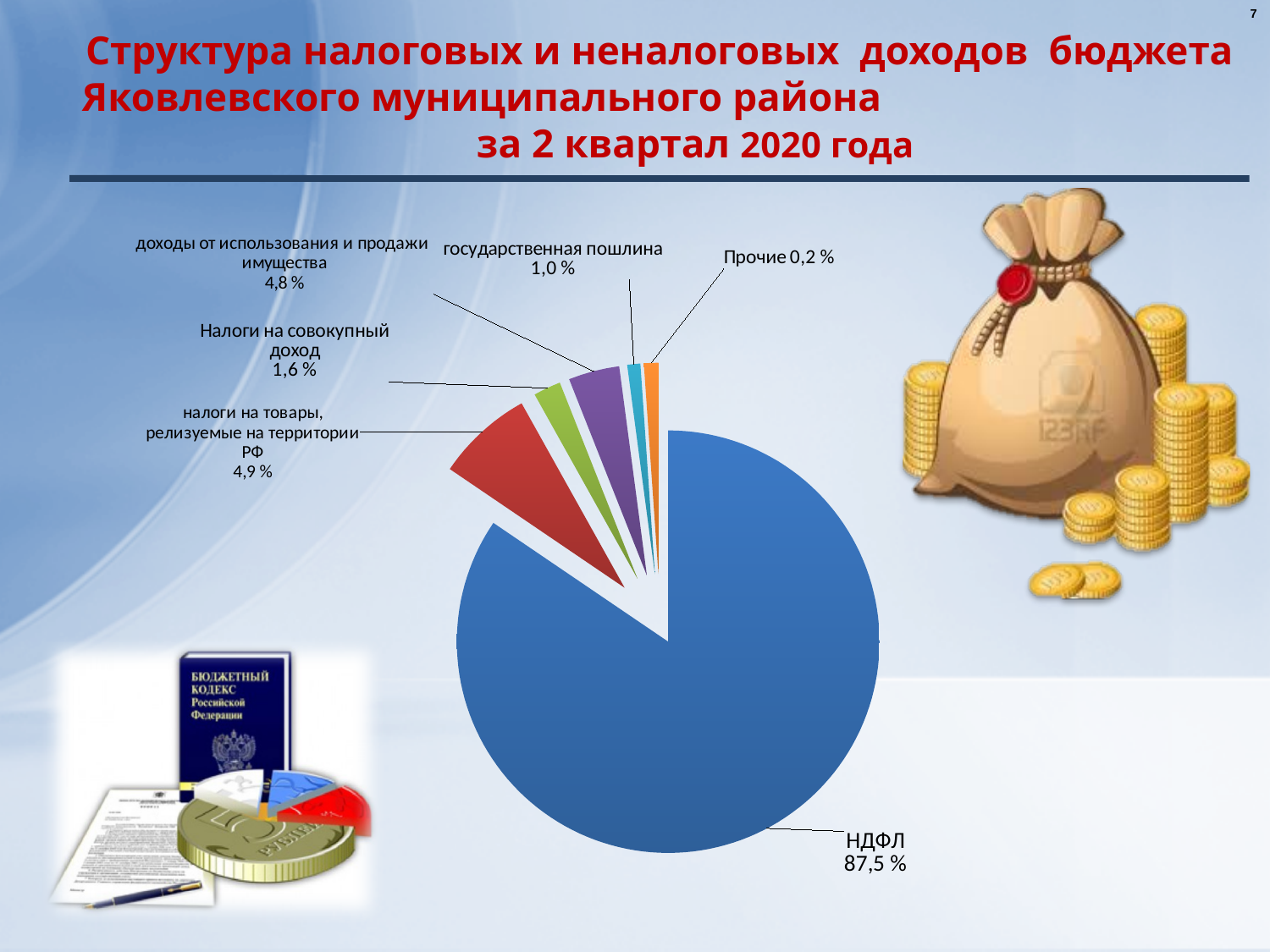
How many slices does the pie chart have? 6 What kind of chart is shown on the slide? pie chart Which category has the smallest slice of the pie? Прочие What is the value shown for Прочие? 0,2 % What is the value shown for доходы от использования и продажи имущества? 4,8 % What is the difference between НДФЛ and налоги на товары, реализуемые на территории РФ? 82,6 % What is the value shown for государственная пошлина? 1,0 % Which category has the largest slice of the pie? НДФЛ What share of the pie does НДФЛ have? 87,5 % Which is larger: Налоги на совокупный доход or государственная пошлина? Налоги на совокупный доход What period does the chart title refer to? 2 квартал 2020 года What is the value shown for Налоги на совокупный доход? 1,6 %